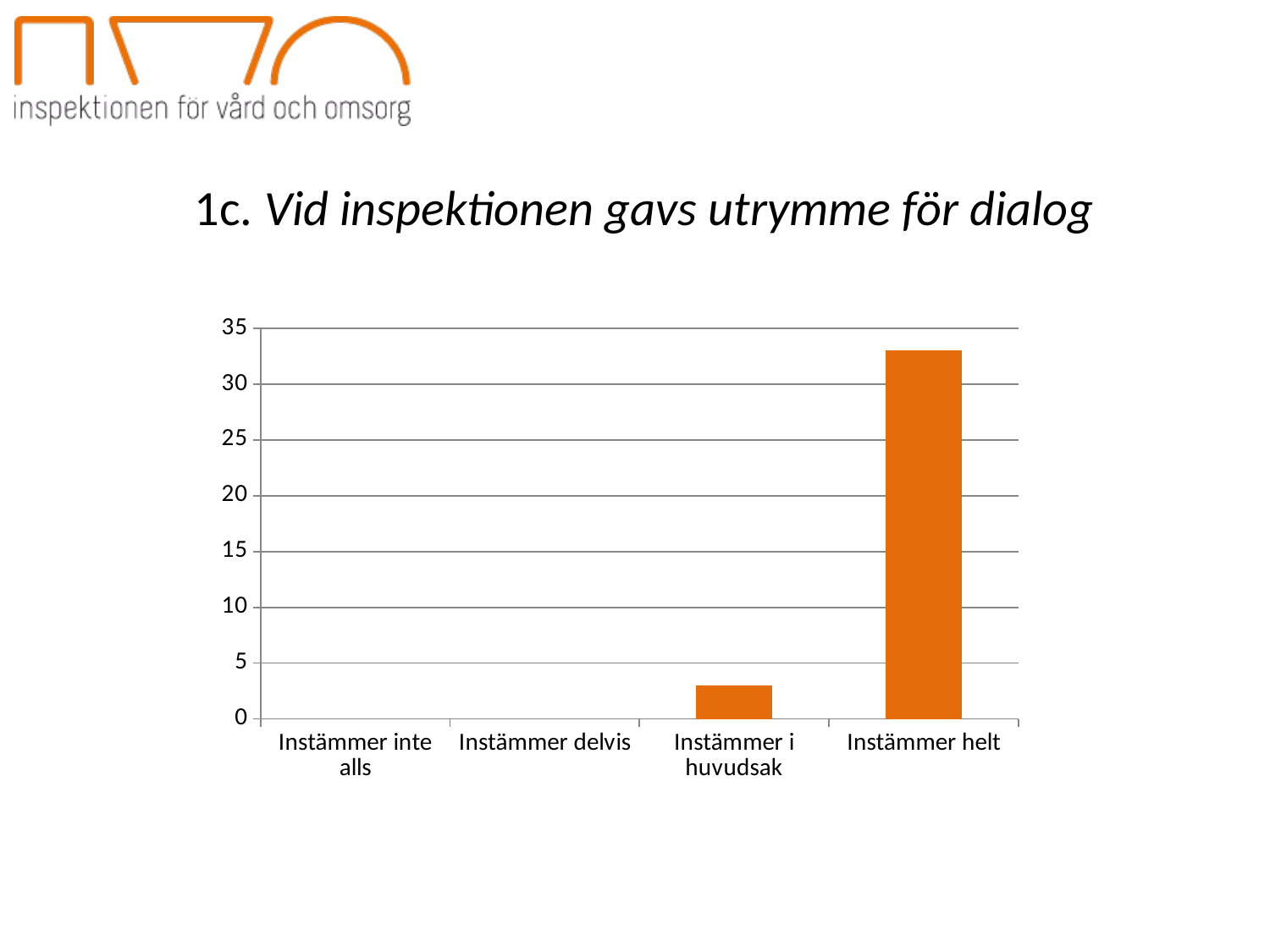
What colour are the bars in the chart? orange Do the values rise or fall moving from left to right along the x axis? rise Is the value for Instämmer i huvudsak greater or less than 5? less What is the highest value shown on the y axis of the chart? 35 Which is larger, the value for Instämmer helt or the value for Instämmer i huvudsak? Instämmer helt Which category has the highest value in the chart? Instämmer helt What is the title of the slide above the chart? 1c. Vid inspektionen gavs utrymme för dialog Which is larger, the value for Instämmer i huvudsak or the value for Instämmer delvis? Instämmer i huvudsak Is the value for Instämmer helt greater or less than 30? greater Is the value for Instämmer helt greater or less than 35? less How many categories are shown on the x axis of the chart? 4 What kind of chart is shown on the slide? bar chart